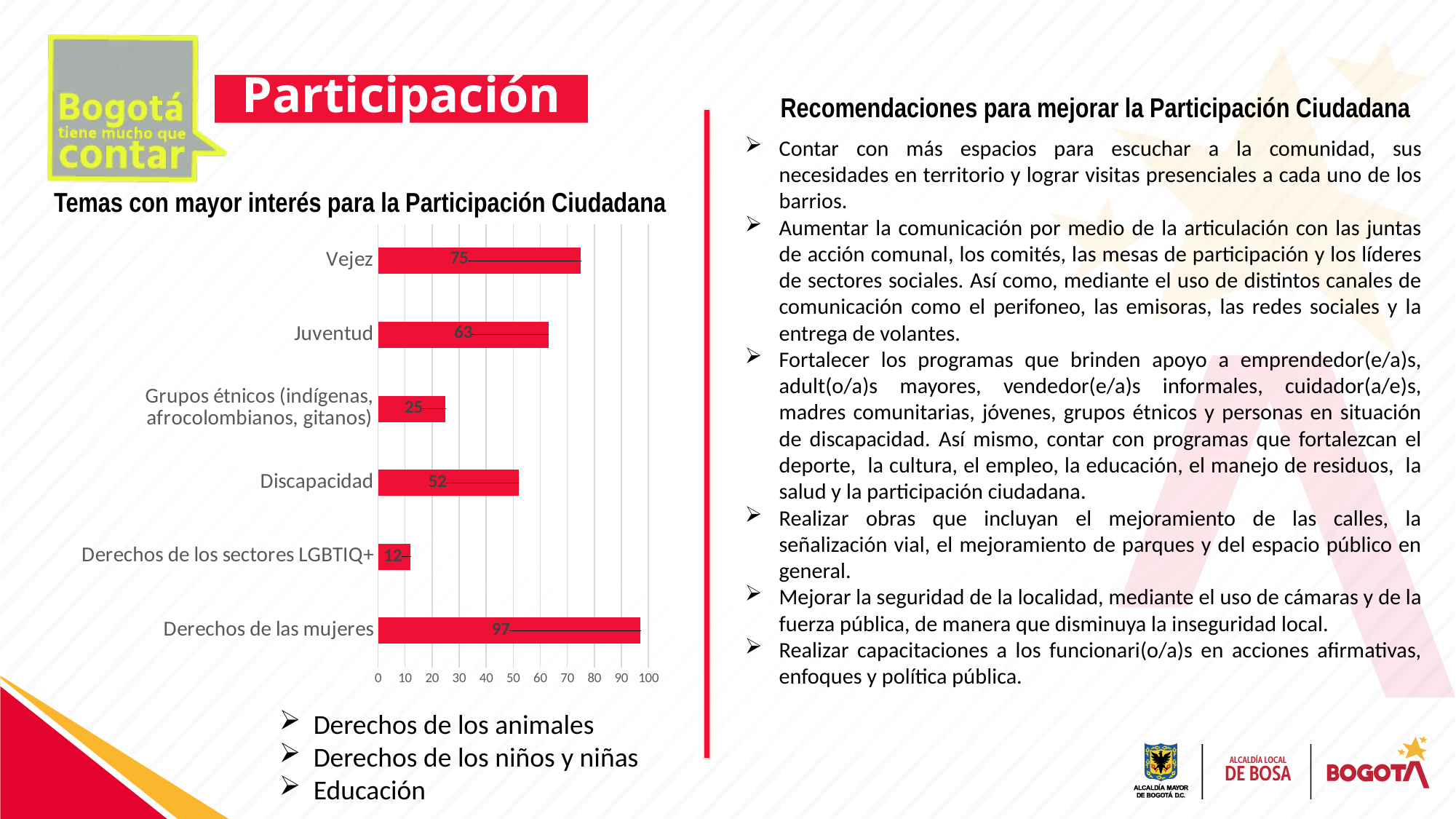
What is the value for Derechos de los sectores LGBTIQ+? 12 Which category has the highest value? Derechos de las mujeres What is the value for Discapacidad? 52 What is the difference between the values for Derechos de las mujeres and Vejez? 22 What is the value for Juventud? 63 Is the value for Grupos étnicos (indígenas, afrocolombianos, gitanos) greater or less than 30? less What is the title of the chart? Temas con mayor interés para la Participación Ciudadana Which is larger, the value for Juventud or the value for Discapacidad? Juventud How many categories are shown in the chart? 6 What kind of chart is shown on the slide? bar chart What is the value for Vejez? 75 Which category has the lowest value? Derechos de los sectores LGBTIQ+